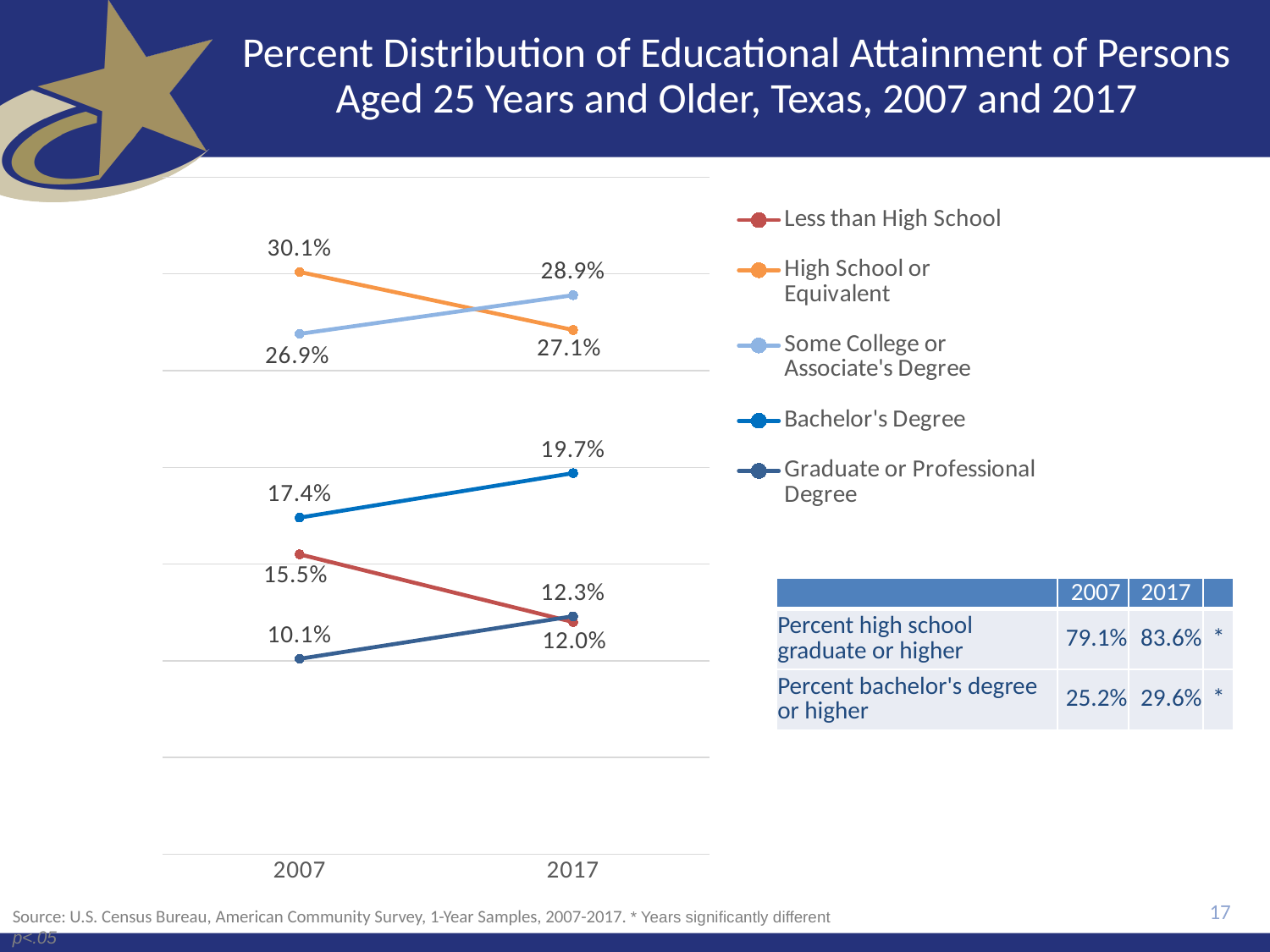
What was the value for Some College or Associate's Degree in 2017? 28.9% How many series does the legend list? 5 What type of chart is shown on the slide? Line chart Which was larger in 2017: High School or Equivalent or Some College or Associate's Degree? Some College or Associate's Degree Did the value for Some College or Associate's Degree rise or fall from 2007 to 2017? Rise What was the value for High School or Equivalent in 2007? 30.1% What was the value for Less than High School in 2007? 15.5% By how many percentage points did the Less than High School value change from 2007 to 2017? 3.5 percentage points (decrease) What was the value for Bachelor's Degree in 2017? 19.7% Which series had the highest value in 2007? High School or Equivalent Which series had the lowest value in 2017? Less than High School What was the value for Graduate or Professional Degree in 2007? 10.1%